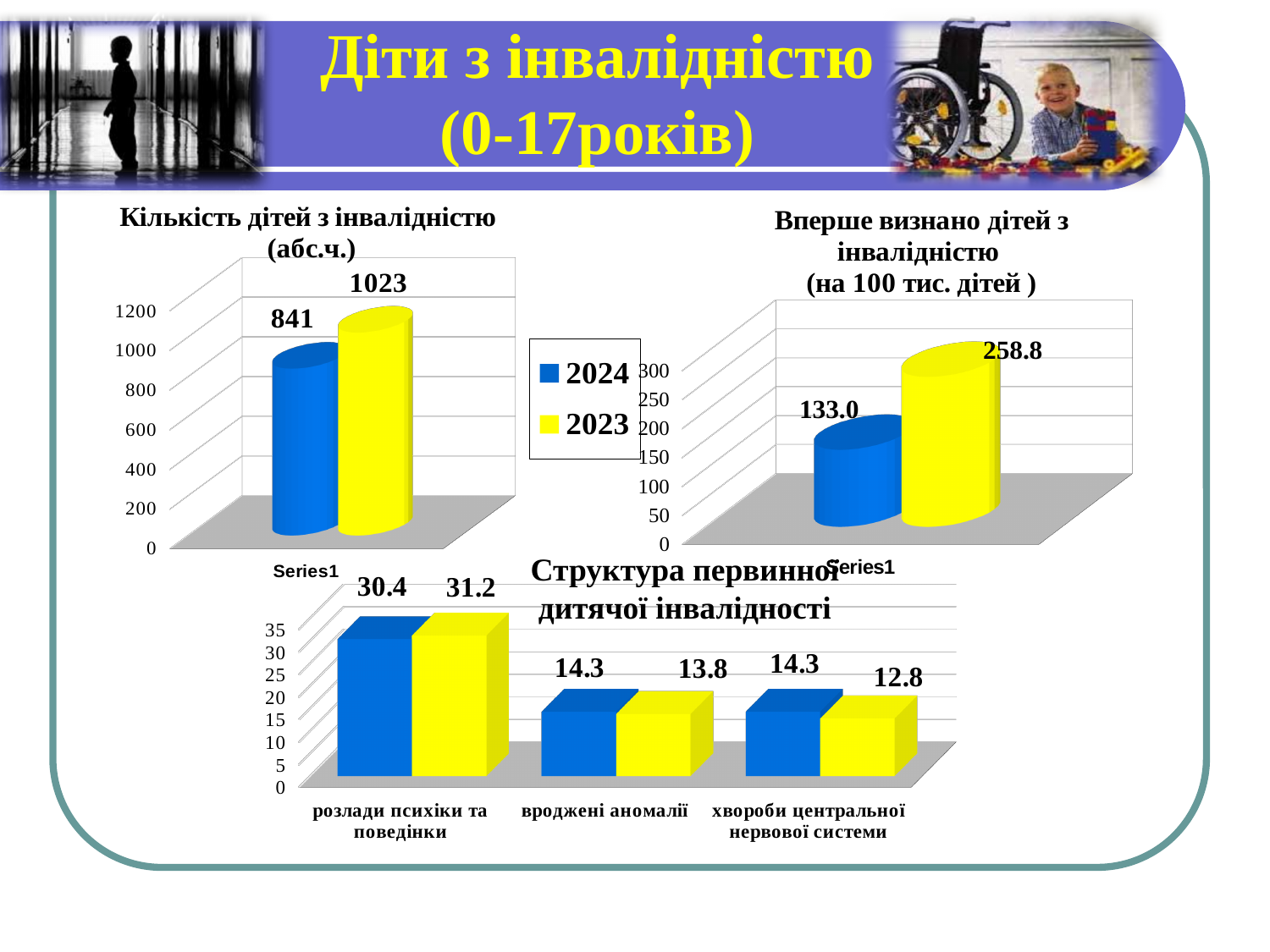
In the chart titled "Вперше визнано дітей з інвалідністю (на 100 тис. дітей)", which bar is larger, the blue one or the yellow one? the yellow one In the chart titled "Кількість дітей з інвалідністю (абс.ч.)", what value is shown on the blue bar? 841 In the bottom chart titled "Структура первинної дитячої інвалідності", which category has the highest values? розлади психіки та поведінки In the bottom chart titled "Структура первинної дитячої інвалідності", what is the yellow bar value for "хвороби центральної нервової системи"? 12.8 In the chart titled "Вперше визнано дітей з інвалідністю (на 100 тис. дітей)", what value is shown on the yellow bar? 258.8 Which two years are listed in the legend shown between the top two charts? 2024 and 2023 In the chart titled "Кількість дітей з інвалідністю (абс.ч.)", what is the difference between the yellow bar and the blue bar? 182 In the bottom chart titled "Структура первинної дитячої інвалідності", what is the difference between the blue and yellow bars for "вроджені аномалії"? 0.5 In the chart titled "Вперше визнано дітей з інвалідністю (на 100 тис. дітей)", what value is shown on the blue bar? 133.0 In the bottom chart titled "Структура первинної дитячої інвалідності", how many categories are shown on the x axis? 3 In the bottom chart titled "Структура первинної дитячої інвалідності", what is the blue bar value for "розлади психіки та поведінки"? 30.4 In the chart titled "Кількість дітей з інвалідністю (абс.ч.)", what value is shown on the yellow bar? 1023